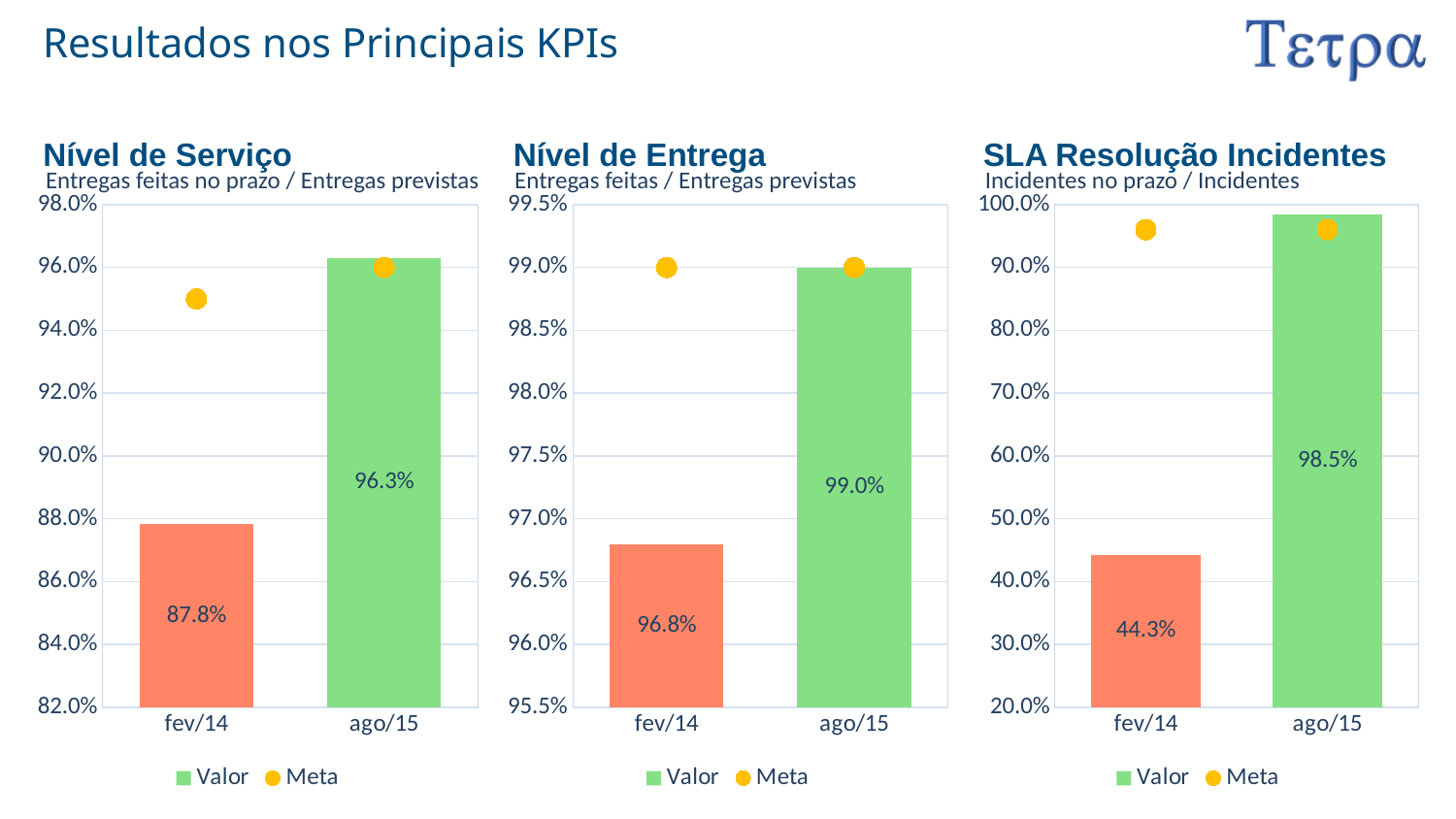
In the Nível de Serviço chart, what is the difference between the Valor for ago/15 and the Valor for fev/14? 8.5 percentage points In the Nível de Entrega chart, what is the Valor for fev/14? 96.8% In the Nível de Serviço chart, what is the Valor for fev/14? 87.8% In the Nível de Serviço chart, what is the Valor for ago/15? 96.3% In the SLA Resolução Incidentes chart, what is the difference between the Valor for ago/15 and the Valor for fev/14? 54.2 percentage points How many series does the legend of the Nível de Entrega chart list? 2 In the Nível de Entrega chart, what is the Meta value shown for ago/15? 99.0% In the Nível de Entrega chart, which period has the higher Valor, fev/14 or ago/15? ago/15 In the SLA Resolução Incidentes chart, is the Meta value for fev/14 greater or less than 90.0%? greater In the Nível de Serviço chart, is the Meta value for fev/14 greater or less than 94.0%? greater What kind of chart is the SLA Resolução Incidentes chart? bar chart In the SLA Resolução Incidentes chart, what is the Valor for ago/15? 98.5%